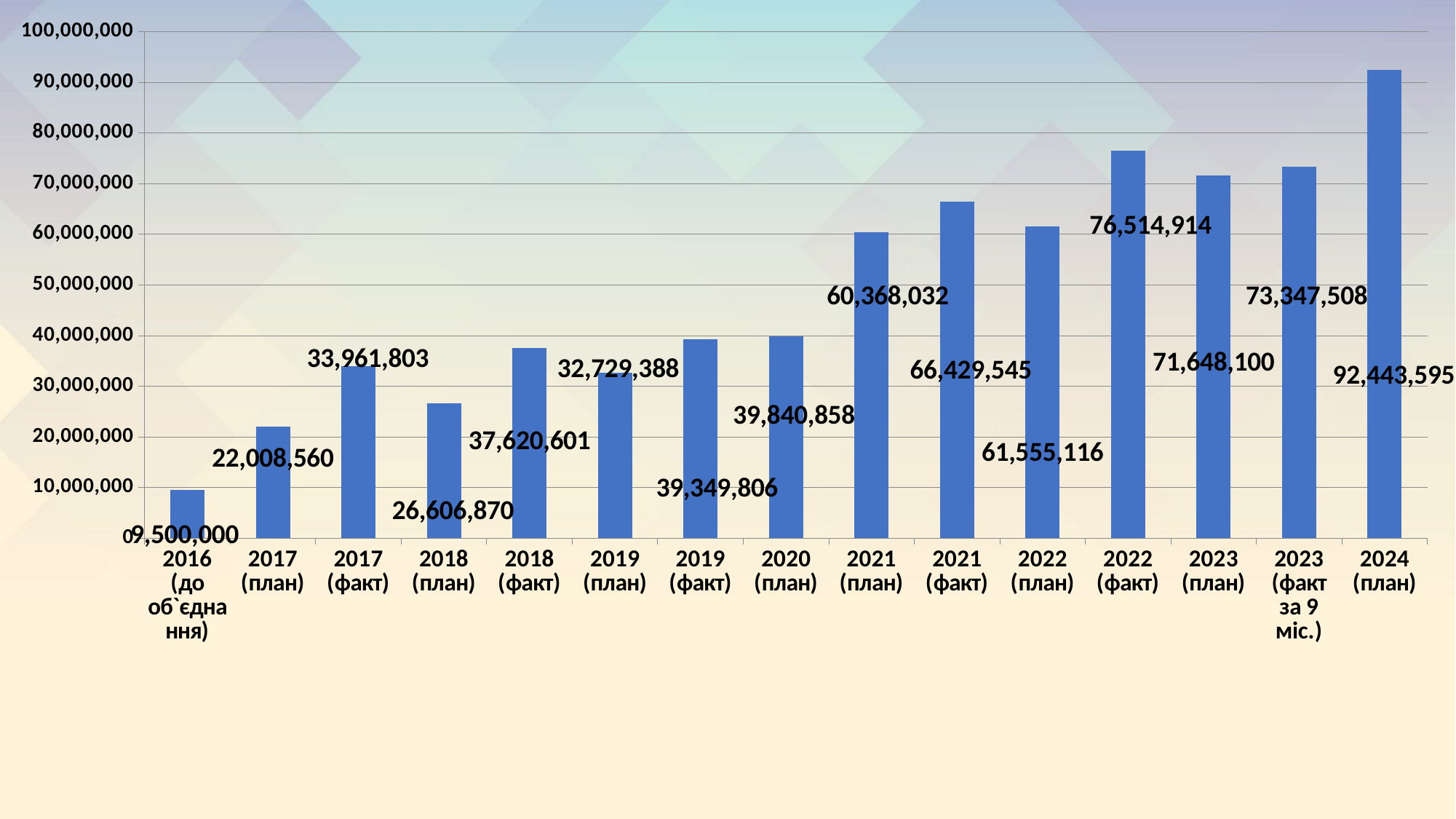
Is the value for 2020 (план) greater or less than 40,000,000? less What is the difference between the values for 2021 (факт) and 2021 (план)? 6,061,513 What is the value for 2017 (факт)? 33,961,803 How many bars (categories) are plotted on the chart? 15 What is the value for 2023 (факт за 9 міс.)? 73,347,508 Do the values generally rise or fall from 2016 to 2024 (план) along the x axis? rise Which is larger, the value for 2022 (план) or the value for 2023 (план)? 2023 (план) What kind of chart is shown on the slide? bar chart Which category has the lowest value? 2016 (до об`єднання) Which category has the highest value? 2024 (план) Is the value for 2024 (план) greater or less than 90,000,000? greater What is the value for 2022 (факт)? 76,514,914